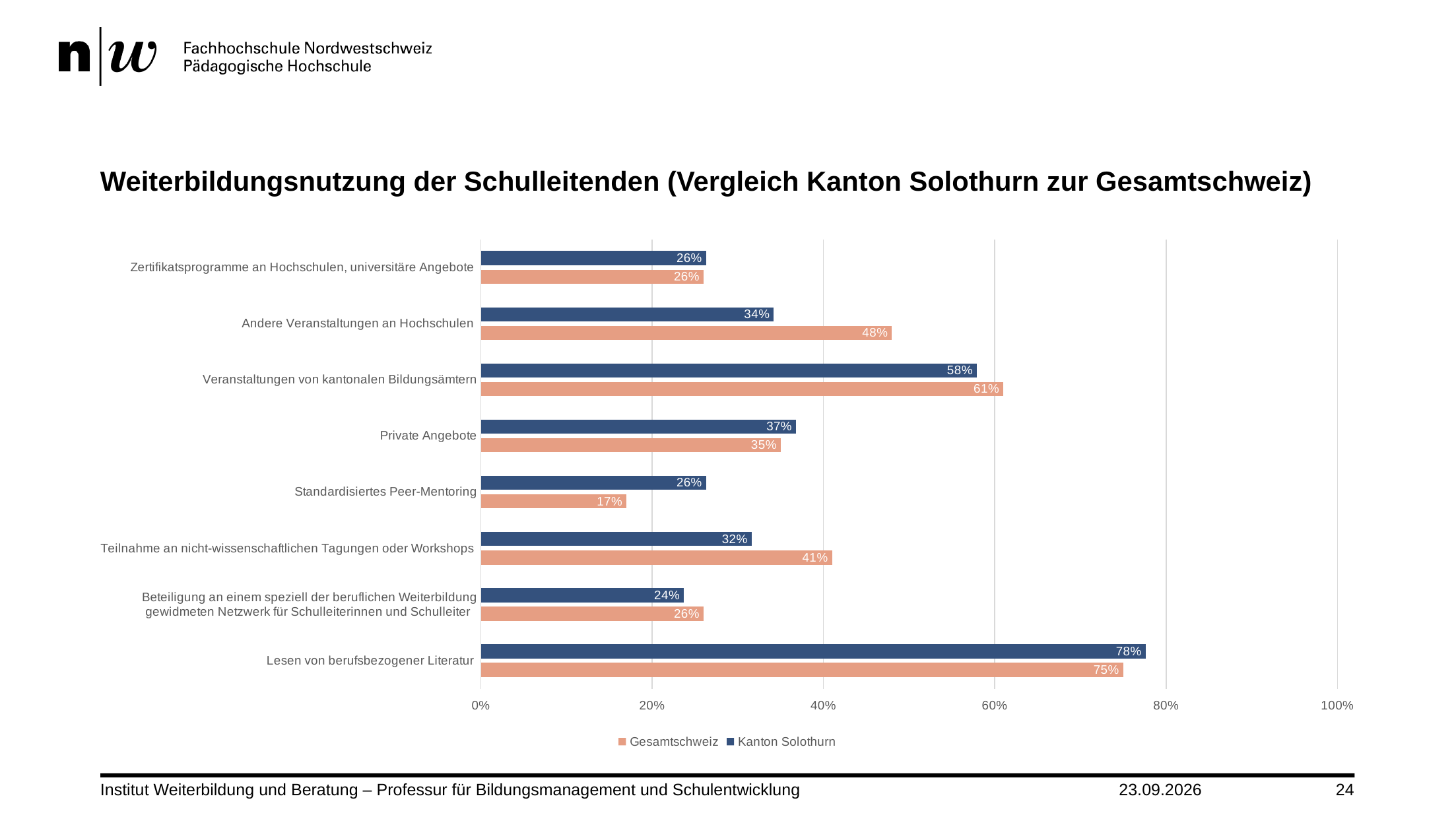
How many series does the legend list? 2 Which series is shown in dark blue? Kanton Solothurn What is the Gesamtschweiz value for Andere Veranstaltungen an Hochschulen? 48% Which category has the highest Kanton Solothurn value? Lesen von berufsbezogener Literatur What is the Kanton Solothurn value for Lesen von berufsbezogener Literatur? 78% Is the Gesamtschweiz value for Veranstaltungen von kantonalen Bildungsämtern greater or less than 60%? greater For Teilnahme an nicht-wissenschaftlichen Tagungen oder Workshops, which series has the larger value, Gesamtschweiz or Kanton Solothurn? Gesamtschweiz What kind of chart is shown on the slide? Bar chart Which category has the lowest Gesamtschweiz value? Standardisiertes Peer-Mentoring What is the Gesamtschweiz value for Standardisiertes Peer-Mentoring? 17% What is the difference between the Gesamtschweiz and Kanton Solothurn values for Andere Veranstaltungen an Hochschulen? 14% How many categories are shown on the chart? 8